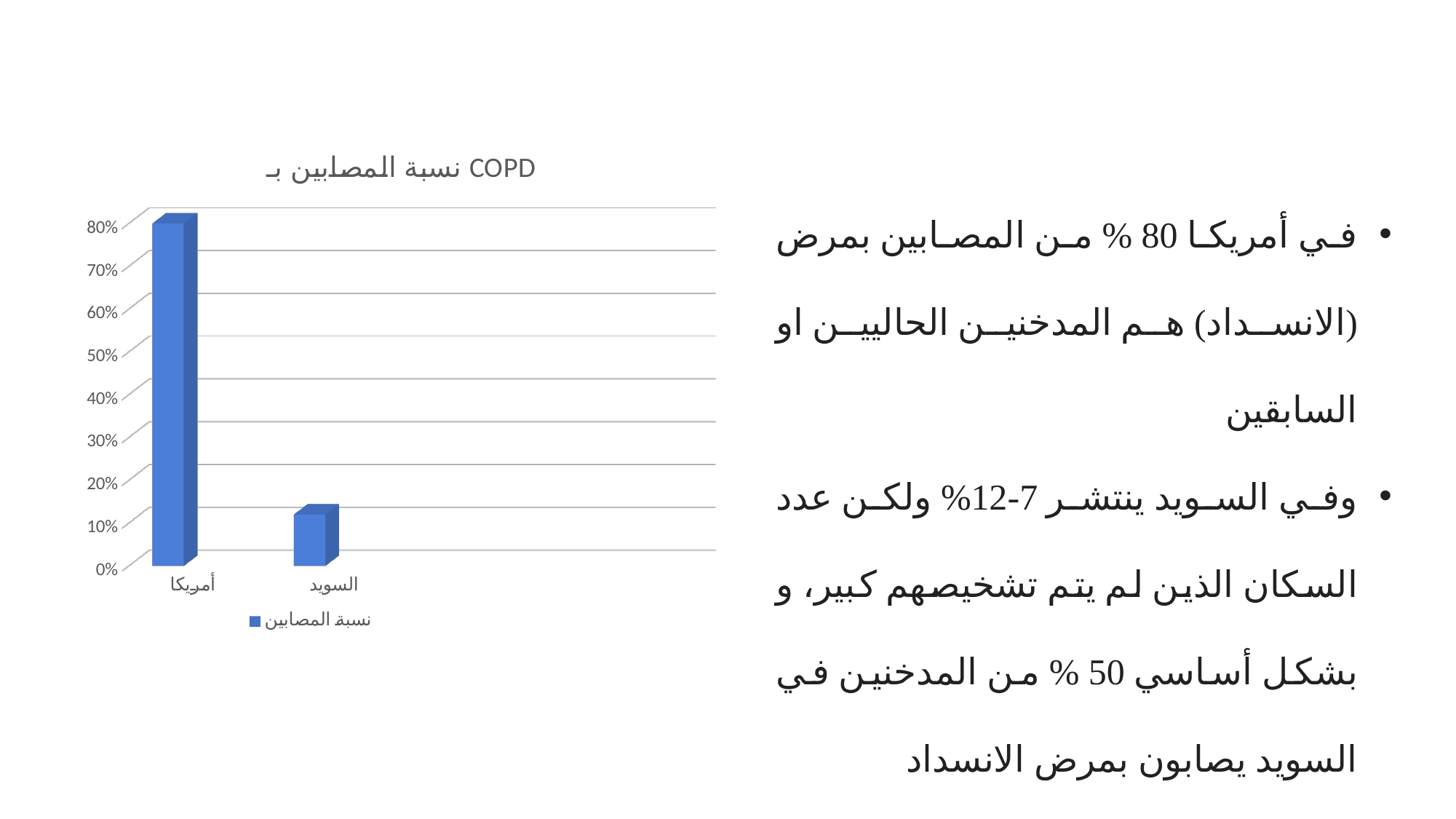
Is the value for أمريكا greater or less than 50%? greater Which category has the highest value in the chart? أمريكا What kind of chart is shown on the slide? Bar chart Which has a larger value in the chart, أمريكا or السويد? أمريكا How many categories are plotted in the chart? 2 Is the value for أمريكا greater or less than 70%? greater How many series does the chart legend list? 1 Which category has the lowest value in the chart? السويد Is the value for السويد greater or less than 20%? less What is the name of the series shown in the chart legend? نسبة المصابين What is the title of the chart? نسبة المصابين بـ COPD